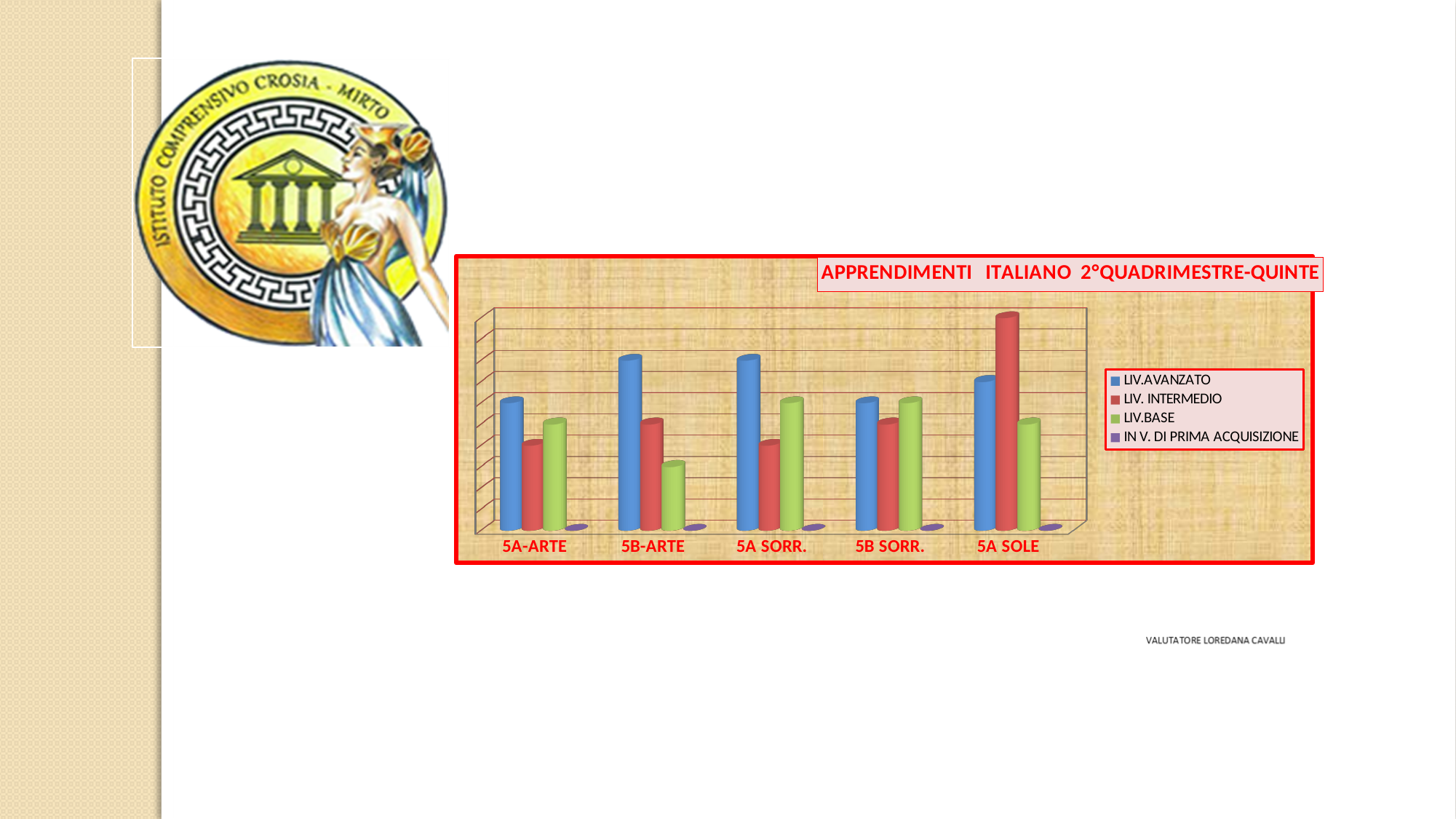
What is the title of the chart? APPRENDIMENTI ITALIANO 2°QUADRIMESTRE-QUINTE For which class is the LIV. INTERMEDIO bar the highest? 5A SOLE For 5A SOLE, which is larger: LIV.AVANZATO or LIV. INTERMEDIO? LIV. INTERMEDIO Which class has the single tallest bar in the chart? 5A SOLE How many series does the chart's legend list? 4 For which class is the LIV.BASE bar the lowest? 5B-ARTE Which series is shown in green in the chart's legend? LIV.BASE For 5A SORR., which is larger: LIV.AVANZATO or LIV. INTERMEDIO? LIV.AVANZATO What kind of chart is shown on the slide? bar chart How many categories (classes) are shown on the x axis of the chart? 5 For 5B-ARTE, which is larger: LIV.AVANZATO or LIV.BASE? LIV.AVANZATO